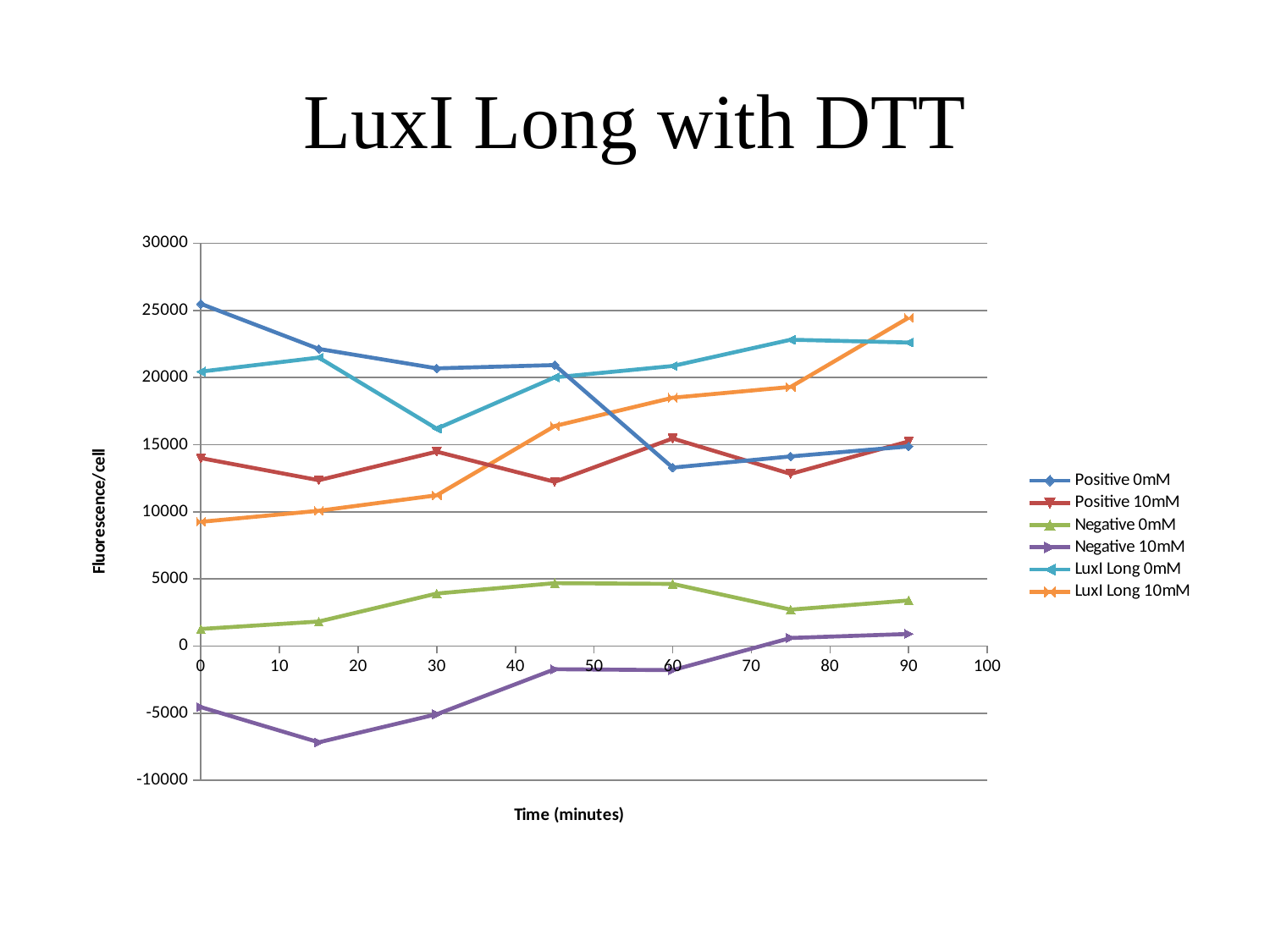
Which series has the highest value at time 90? LuxI Long 10mM Is the value for Positive 0mM at time 0 greater or less than 20000? greater Is the value for Negative 10mM at time 15 greater or less than -5000? less How many series does the legend list? 6 Does the LuxI Long 10mM series rise or fall from time 0 to time 90? rise Which series has the lowest value at time 90? Negative 10mM What is the label of the y axis? Fluorescence/cell What is the title of the chart? LuxI Long with DTT What kind of chart is shown on the slide? line chart At time 30, which is larger: Positive 0mM or LuxI Long 0mM? Positive 0mM Which series has the highest value at time 0? Positive 0mM How many time points are plotted for each series? 7